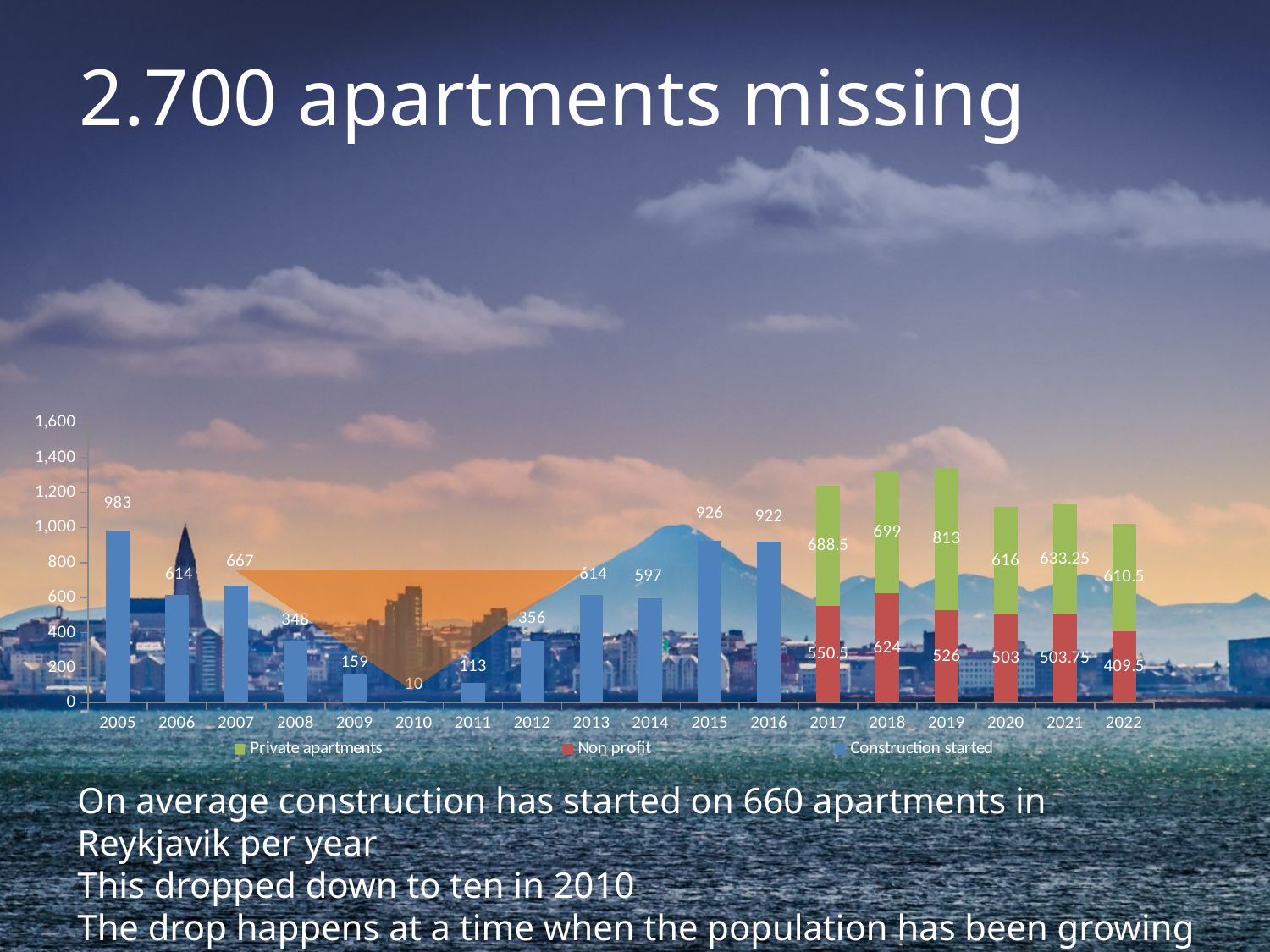
What is the value for Construction started in 2010? 10 Which year has the lowest value for Construction started? 2010 Which year has the highest value for Construction started? 2005 What is the Private apartments value in 2019? 813 How many series does the legend list? 3 Do the Construction started values rise or fall from 2005 to 2010? fall How many years are shown on the x axis? 18 What is the value for Construction started in 2005? 983 What is the Non profit value in 2018? 624 Which year has the larger Private apartments value, 2018 or 2019? 2019 What is the difference between the Construction started values for 2015 and 2016? 4 What is the total of the stacked bar for 2017? 1,239